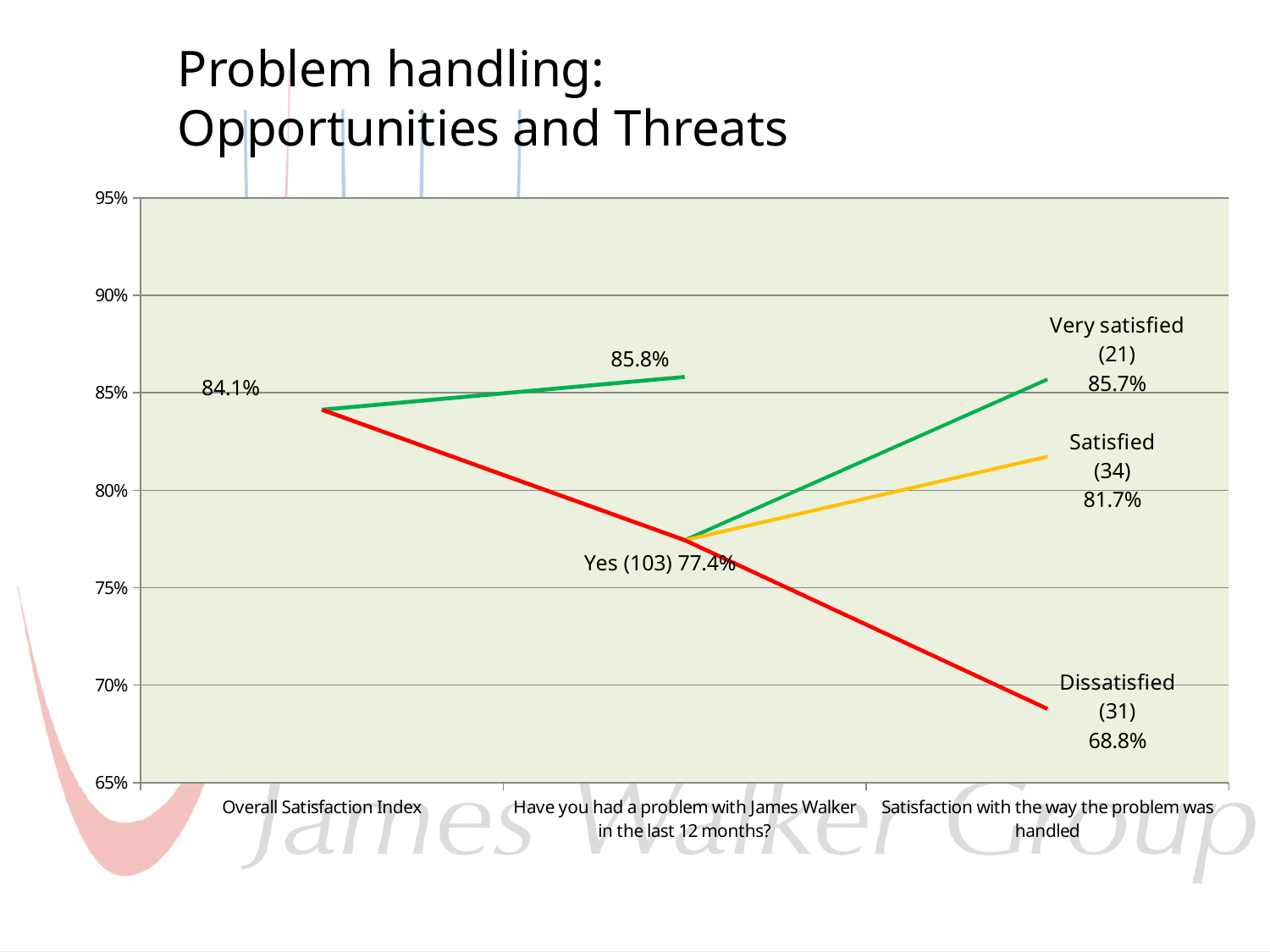
Which of the three problem-handling groups has the highest value? Very satisfied What is the value shown for the Very satisfied group under 'Satisfaction with the way the problem was handled'? 85.7% Is the value for the Dissatisfied group greater or less than 70%? less What type of chart is shown on the slide? Line chart Which of the three problem-handling groups (Very satisfied, Satisfied, Dissatisfied) has the lowest value? Dissatisfied What is the Overall Satisfaction Index value shown at the left of the chart? 84.1% How many categories are shown on the x axis of the chart? 3 How many respondents are in the Satisfied group, according to the label? 34 Which is larger: the Overall Satisfaction Index (84.1%) or the value for the Yes (103) group (77.4%)? Overall Satisfaction Index What is the difference between the Very satisfied value (85.7%) and the Dissatisfied value (68.8%)? 16.9% What is the value shown for the Dissatisfied group? 68.8% What satisfaction value is shown for customers who answered Yes to having had a problem in the last 12 months? 77.4%